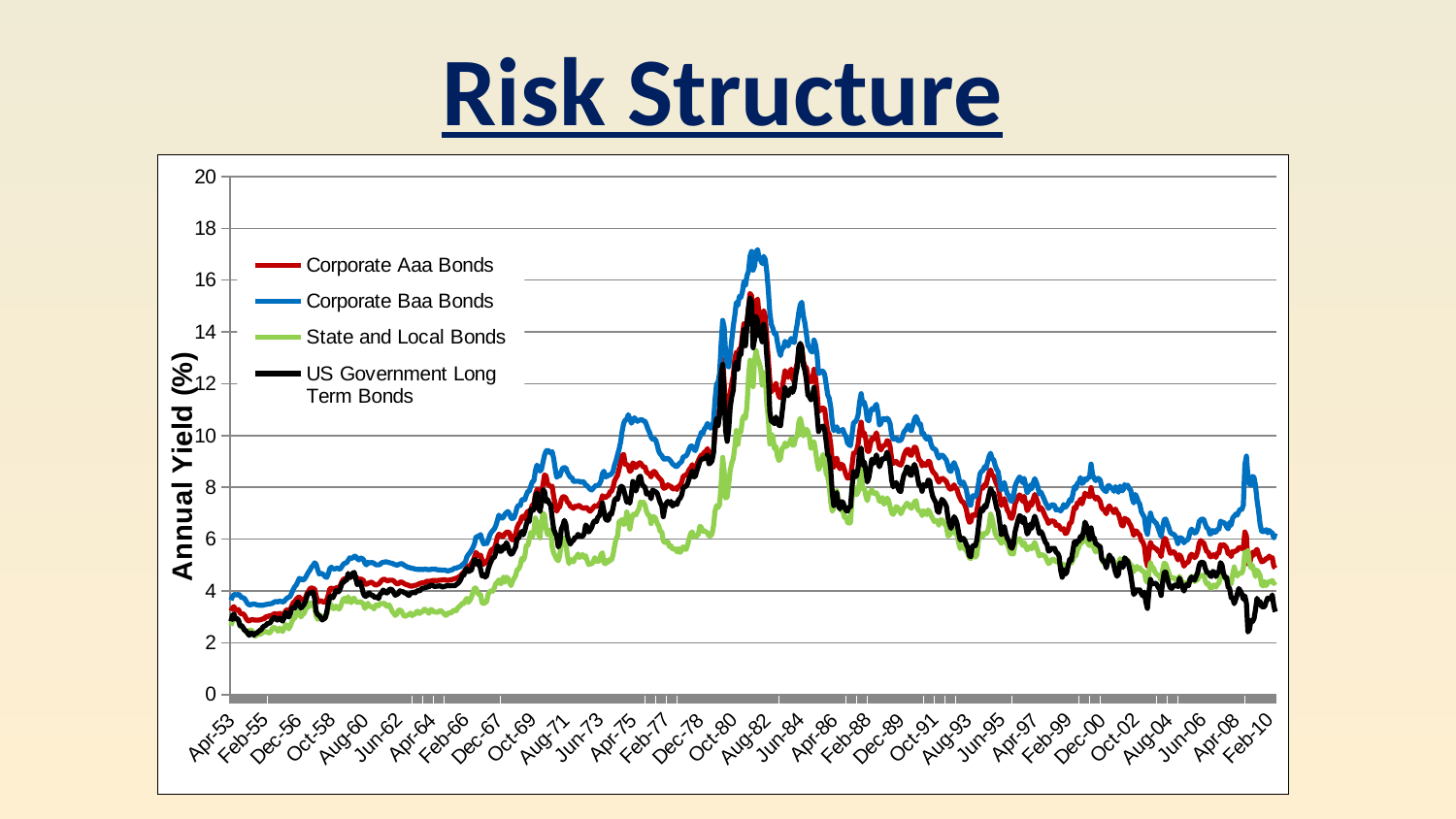
Do the yields generally rise or fall from Aug-82 to Feb-10? fall Which series reaches the highest peak on the chart? Corporate Baa Bonds Is the value for US Government Long Term Bonds at Apr-53 greater or less than 4? less How many series does the chart's legend list? 4 Which series is the lowest around Aug-82? State and Local Bonds Is the peak value for Corporate Aaa Bonds greater or less than 14? greater Around Aug-82, which is larger: the value for Corporate Baa Bonds or the value for State and Local Bonds? Corporate Baa Bonds What is the label on the chart's vertical axis? Annual Yield (%) Is the peak value for State and Local Bonds greater or less than 14? less What kind of chart is shown on the slide? line chart